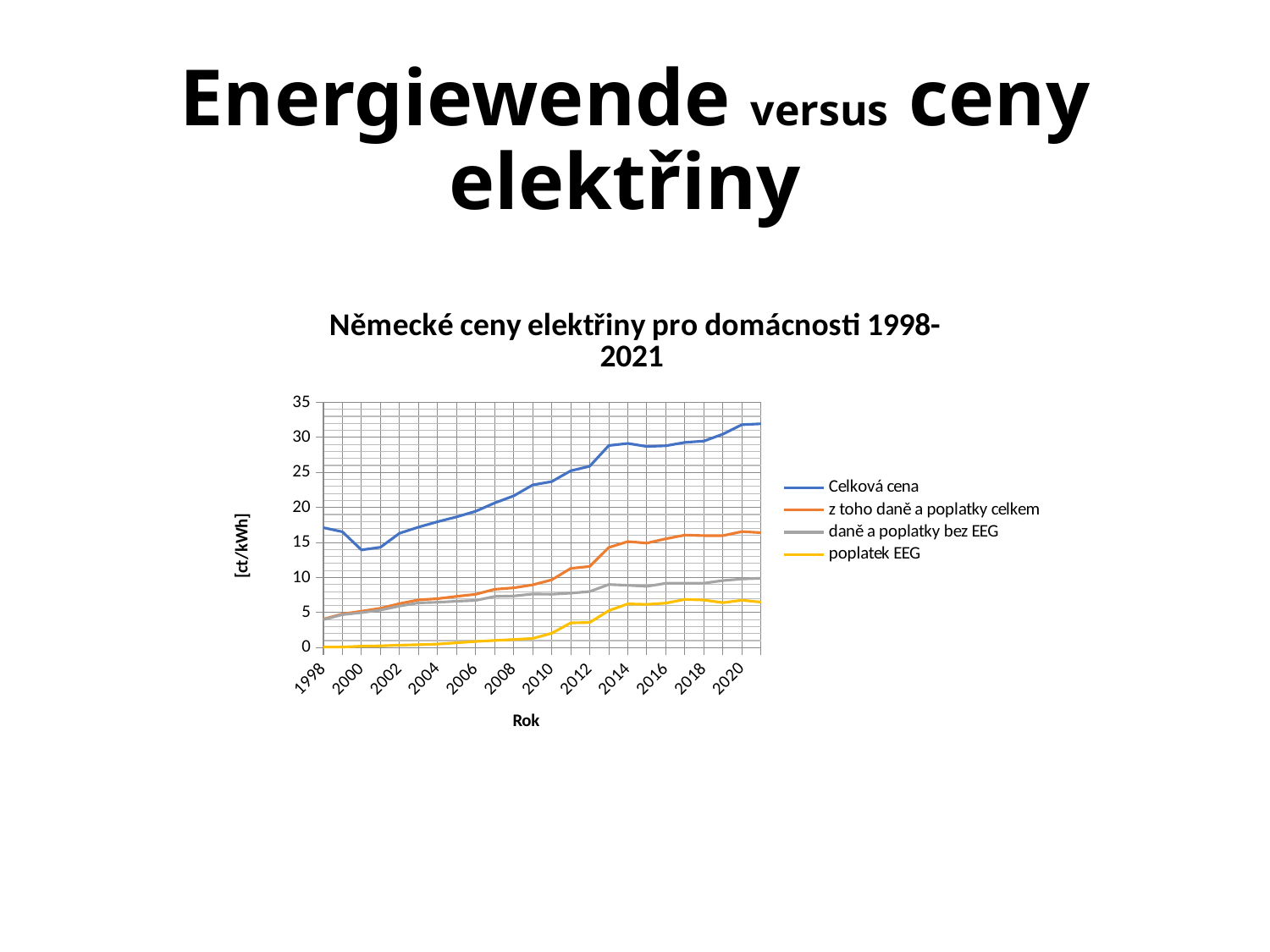
Is the value of daně a poplatky bez EEG in 2021 greater or less than 15? less Is the value of Celková cena in 2021 greater or less than 30? greater How many years are plotted along the x axis? 24 What kind of chart is shown on the slide? line chart Does Celková cena rise or fall overall from 1998 to 2021? rise How many series does the legend list? 4 Which series has the lowest value in 1998? poplatek EEG Is the value of z toho daně a poplatky celkem in 2021 greater or less than 15? greater Which series has the highest value in 2021? Celková cena What is the label of the y axis? [ct/kWh]